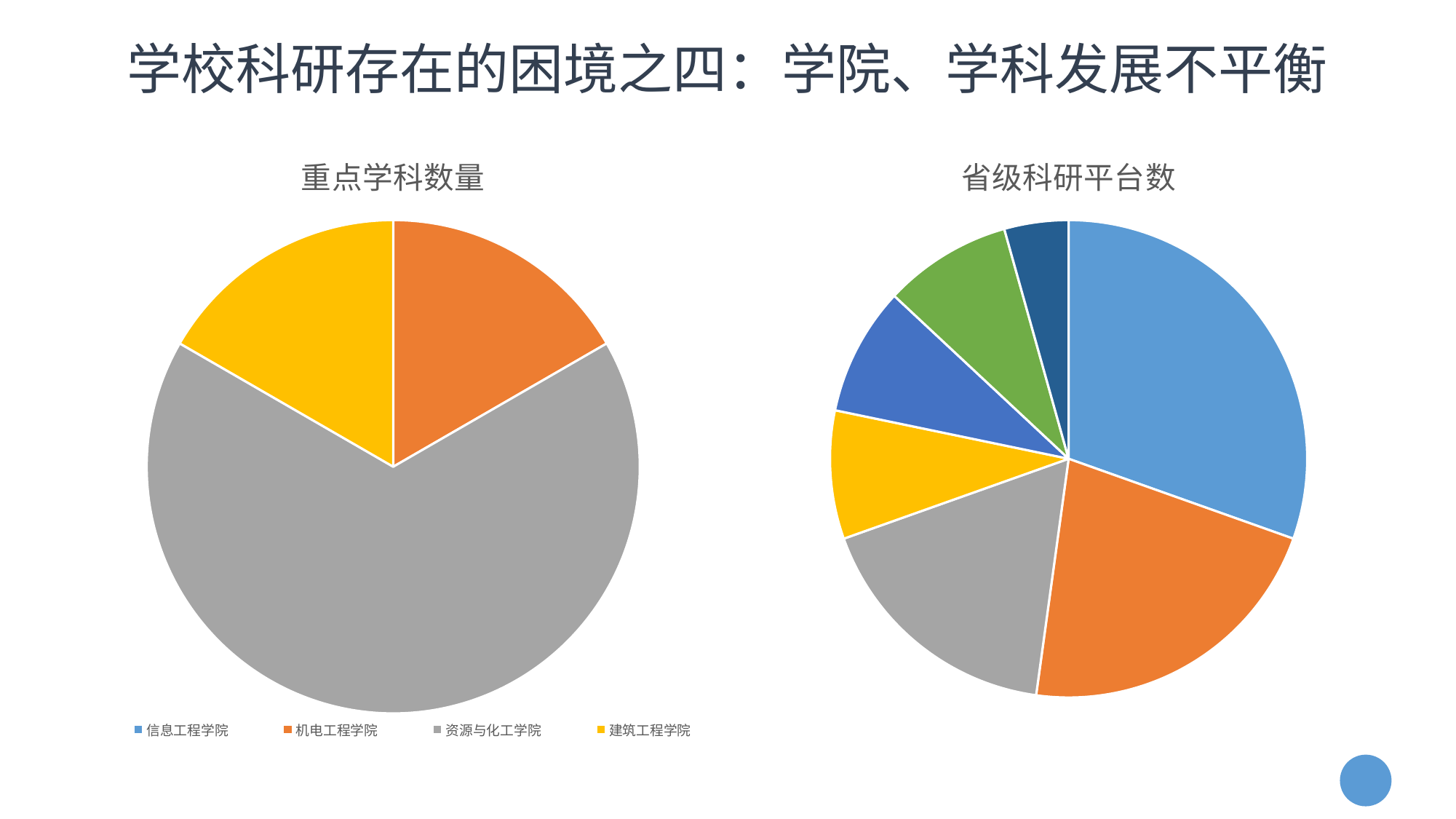
In the right chart (省级科研平台数), what colour is the largest slice? light blue What kind of chart is the right chart titled 省级科研平台数? pie chart In the left chart (重点学科数量), does 资源与化工学院 account for more or less than half of the pie? more What kind of chart is the left chart titled 重点学科数量? pie chart In the left chart (重点学科数量), which legend category has the smallest share (no visible slice)? 信息工程学院 In the right chart (省级科研平台数), how many slices does the pie have? 7 In the left chart (重点学科数量), which is larger: the share of 资源与化工学院 or the share of 机电工程学院? 资源与化工学院 In the left chart (重点学科数量), how many categories does the legend list? 4 In the left chart (重点学科数量), which category has the largest share? 资源与化工学院 In the right chart (省级科研平台数), what colour is the smallest slice? dark navy blue